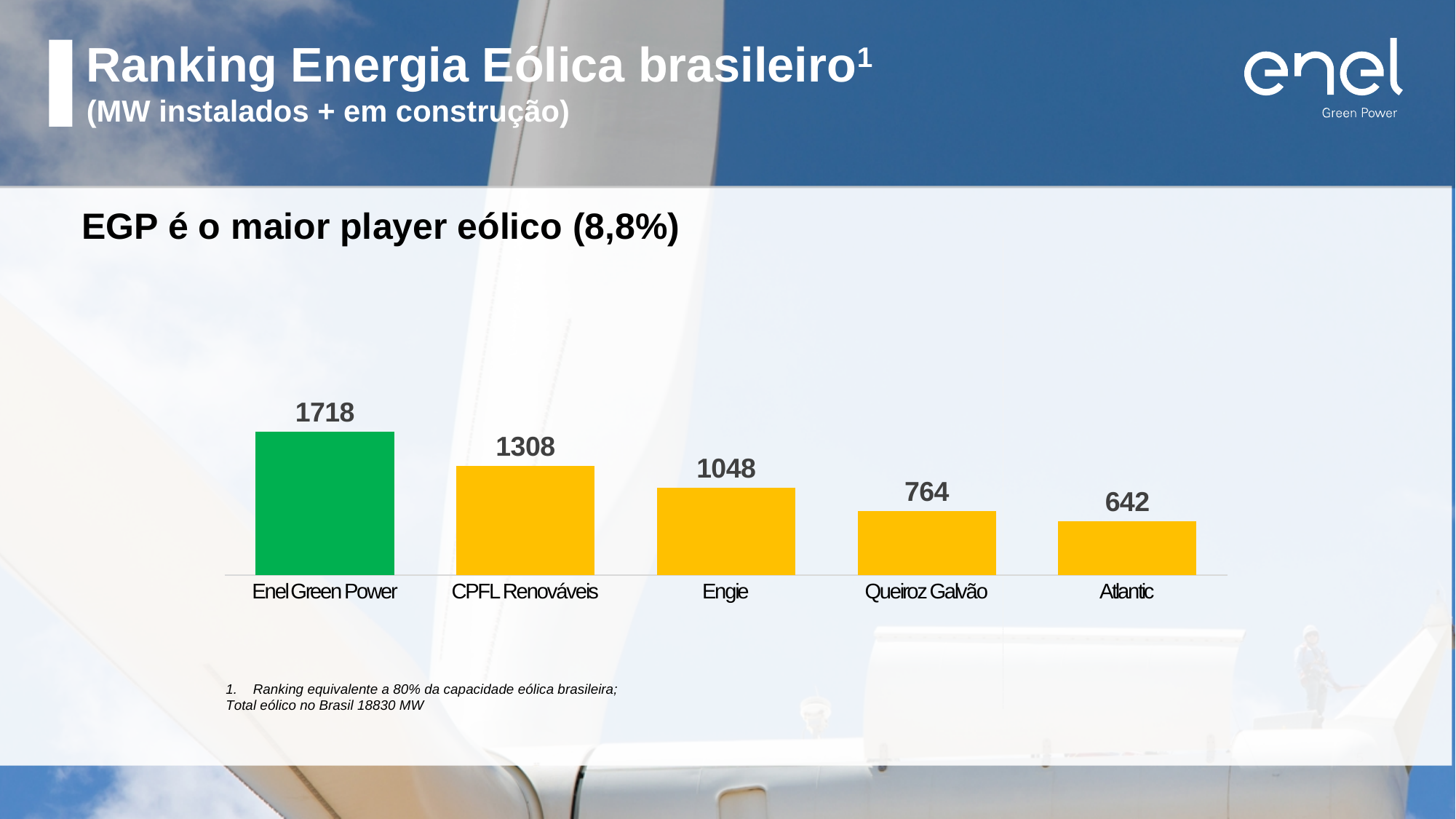
Which company has the lowest value? Atlantic Which bar is coloured green rather than yellow? Enel Green Power What is the value for Queiroz Galvão? 764 What is the difference between the values for Enel Green Power and CPFL Renováveis? 410 What is the value for Enel Green Power? 1718 Which company has the highest value? Enel Green Power What is the value for Atlantic? 642 What kind of chart is shown on the slide? Bar chart Which is larger, the value for Engie or the value for Queiroz Galvão? Engie What is the value for Engie? 1048 How many companies are shown in the chart? 5 What is the value for CPFL Renováveis? 1308